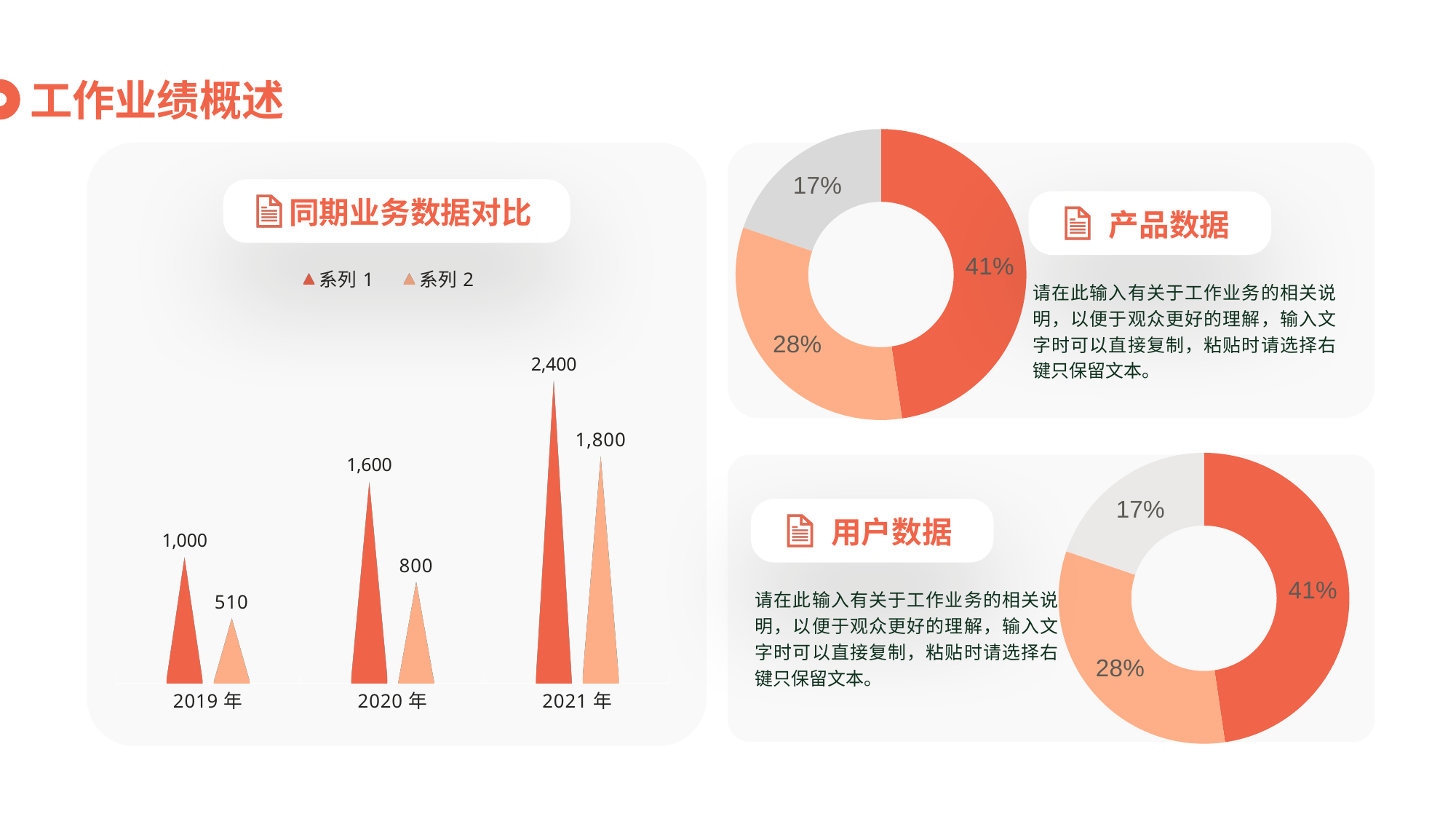
How many years are shown on the x axis of the 同期业务数据对比 chart? 3 In the 同期业务数据对比 chart, do the values of 系列 2 rise or fall from 2019 年 to 2021 年? rise How many series does the legend of the 同期业务数据对比 chart list? 2 In the 同期业务数据对比 chart, which is larger in 2021 年: 系列 1 or 系列 2? 系列 1 In the 同期业务数据对比 chart, what is the difference between 系列 1 and 系列 2 in 2020 年? 800 In the 同期业务数据对比 chart, which year has the lowest value for 系列 2? 2019 年 What kind of chart is the 用户数据 chart? donut chart In the 同期业务数据对比 chart, which year has the highest value for 系列 1? 2021 年 In the 产品数据 chart, what share does the largest slice have? 41% In the 同期业务数据对比 chart, what is the value of 系列 1 for 2021 年? 2,400 In the 同期业务数据对比 chart, what is the value of 系列 2 for 2020 年? 800 In the 同期业务数据对比 chart, what is the value of 系列 2 for 2019 年? 510